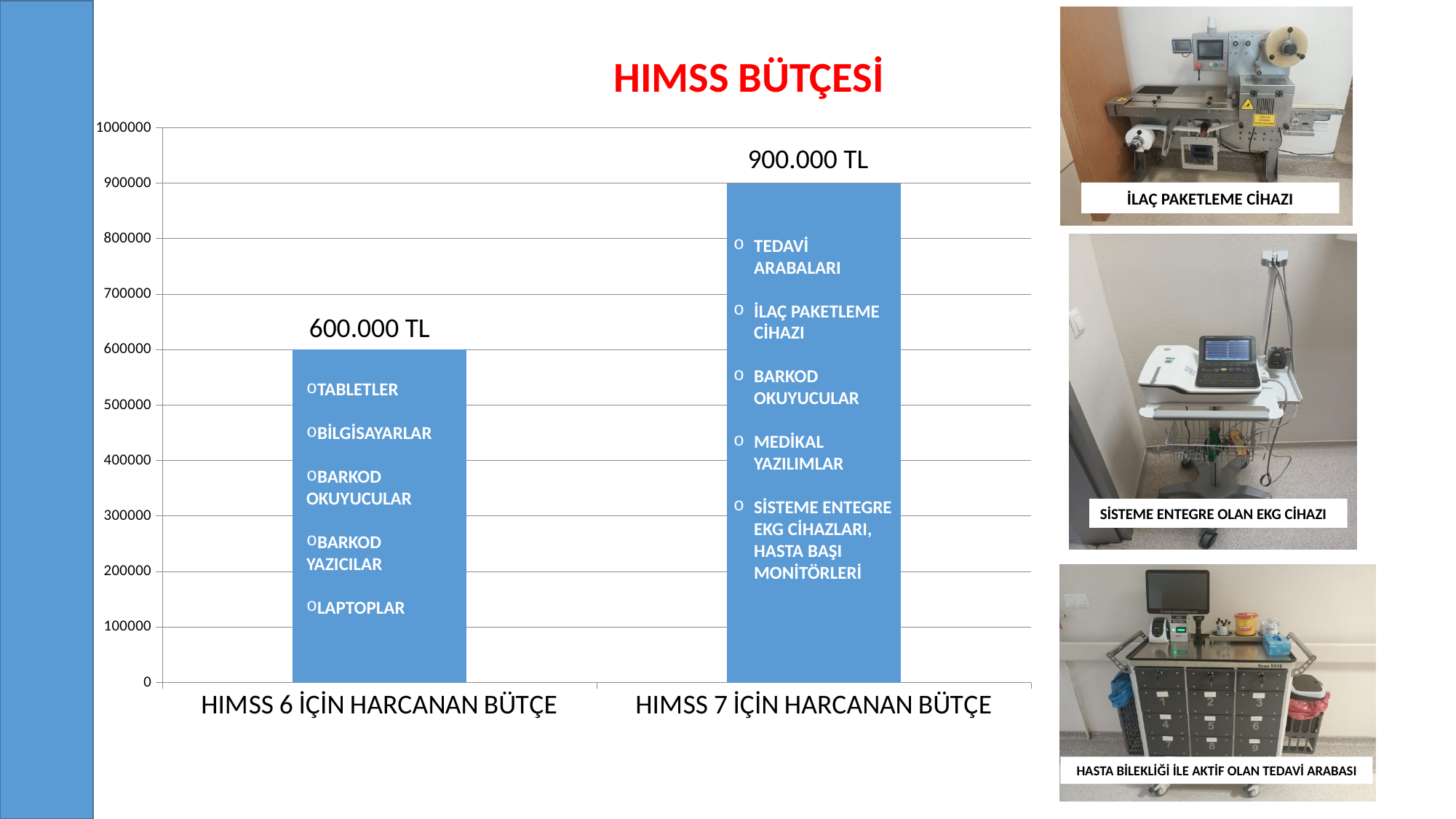
What kind of chart is shown on the slide? bar chart What is the value for HIMSS 6 İÇİN HARCANAN BÜTÇE? 600.000 TL Which is larger, the budget for HIMSS 6 or the budget for HIMSS 7? HIMSS 7 İÇİN HARCANAN BÜTÇE Is the value for HIMSS 7 İÇİN HARCANAN BÜTÇE greater or less than 800000? greater What is the title of the chart? HIMSS BÜTÇESİ Do the values rise or fall from HIMSS 6 to HIMSS 7? rise What is the difference between the HIMSS 7 budget and the HIMSS 6 budget? 300.000 TL What is the value for HIMSS 7 İÇİN HARCANAN BÜTÇE? 900.000 TL Is the value for HIMSS 6 İÇİN HARCANAN BÜTÇE greater or less than 700000? less Which category has the lowest value? HIMSS 6 İÇİN HARCANAN BÜTÇE How many categories are shown on the chart? 2 Which category has the highest value? HIMSS 7 İÇİN HARCANAN BÜTÇE